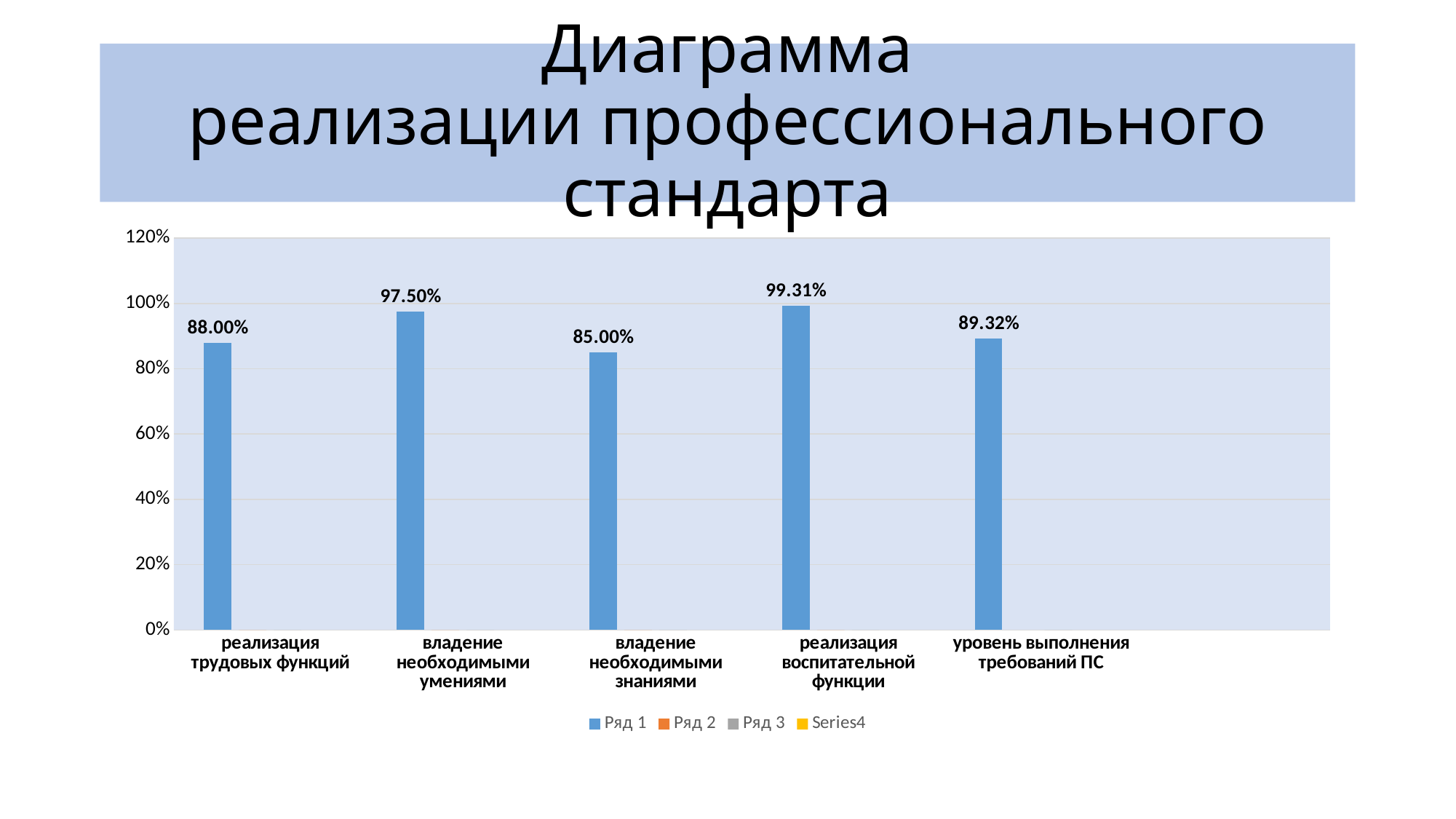
What is the value for «уровень выполнения требований ПС»? 89.32% Is the value for «владение необходимыми знаниями» greater or less than 100%? less How many series does the legend list? 4 Which category has the highest value? реализация воспитательной функции Which is larger: the value for «реализация трудовых функций» or the value for «уровень выполнения требований ПС»? уровень выполнения требований ПС What is the difference between the values for «владение необходимыми умениями» and «владение необходимыми знаниями»? 12.50% Which category has the lowest value? владение необходимыми знаниями What is the value for «владение необходимыми умениями»? 97.50% What is the value for «реализация трудовых функций»? 88.00% What kind of chart is shown on the slide? bar chart How many categories are shown on the x axis? 5 What is the value for «реализация воспитательной функции»? 99.31%